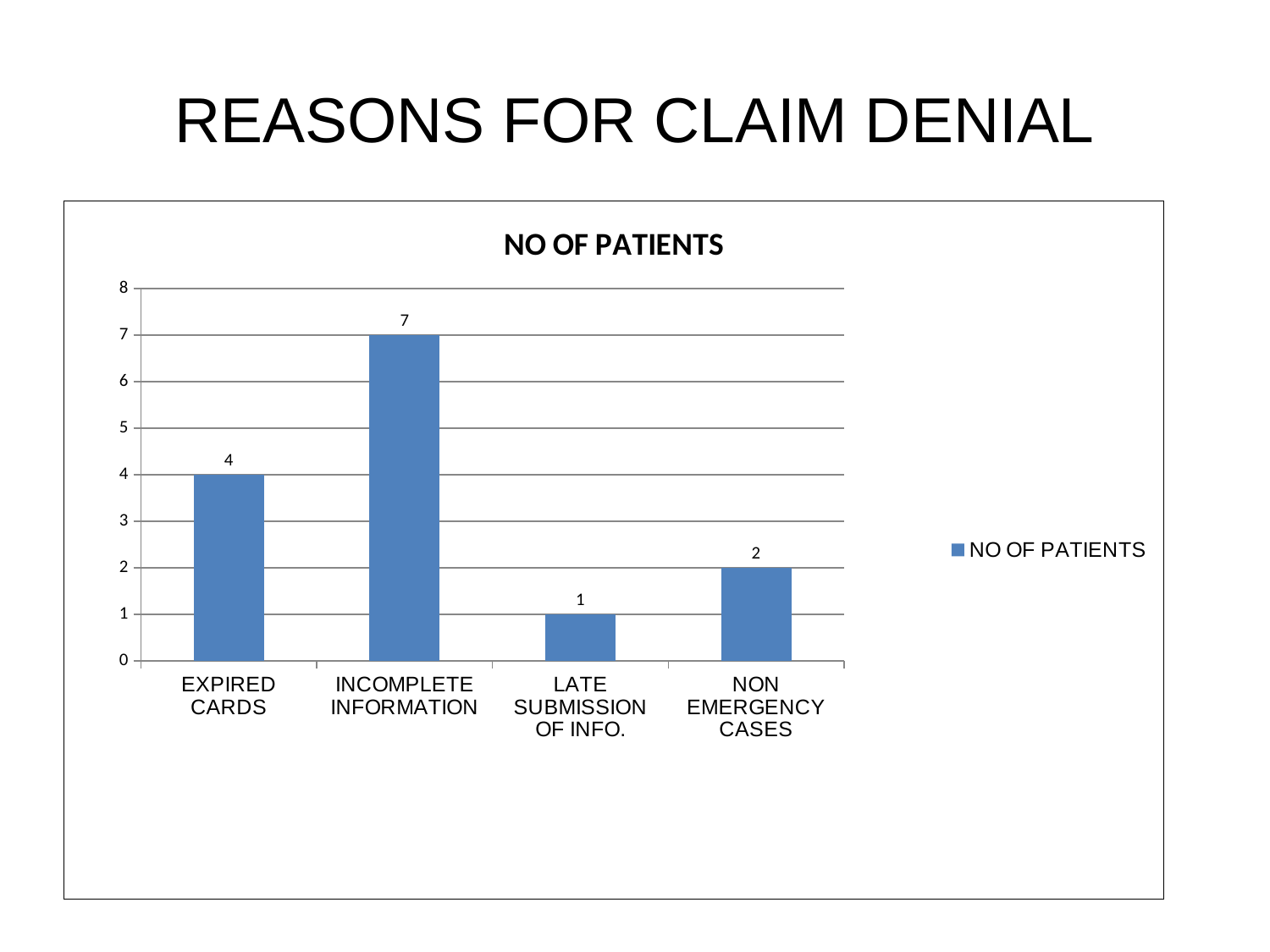
What kind of chart is shown on the slide? Bar chart What is the difference in number of patients between INCOMPLETE INFORMATION and EXPIRED CARDS? 3 Which has more patients, EXPIRED CARDS or NON EMERGENCY CASES? EXPIRED CARDS Which reason for claim denial has the lowest number of patients? LATE SUBMISSION OF INFO. Which reason for claim denial has the highest number of patients? INCOMPLETE INFORMATION What is the number of patients for EXPIRED CARDS? 4 How many reasons for claim denial are shown on the chart? 4 How many series does the legend list? 1 What is the number of patients for INCOMPLETE INFORMATION? 7 What is the title of the chart? NO OF PATIENTS What is the number of patients for LATE SUBMISSION OF INFO.? 1 What is the number of patients for NON EMERGENCY CASES? 2